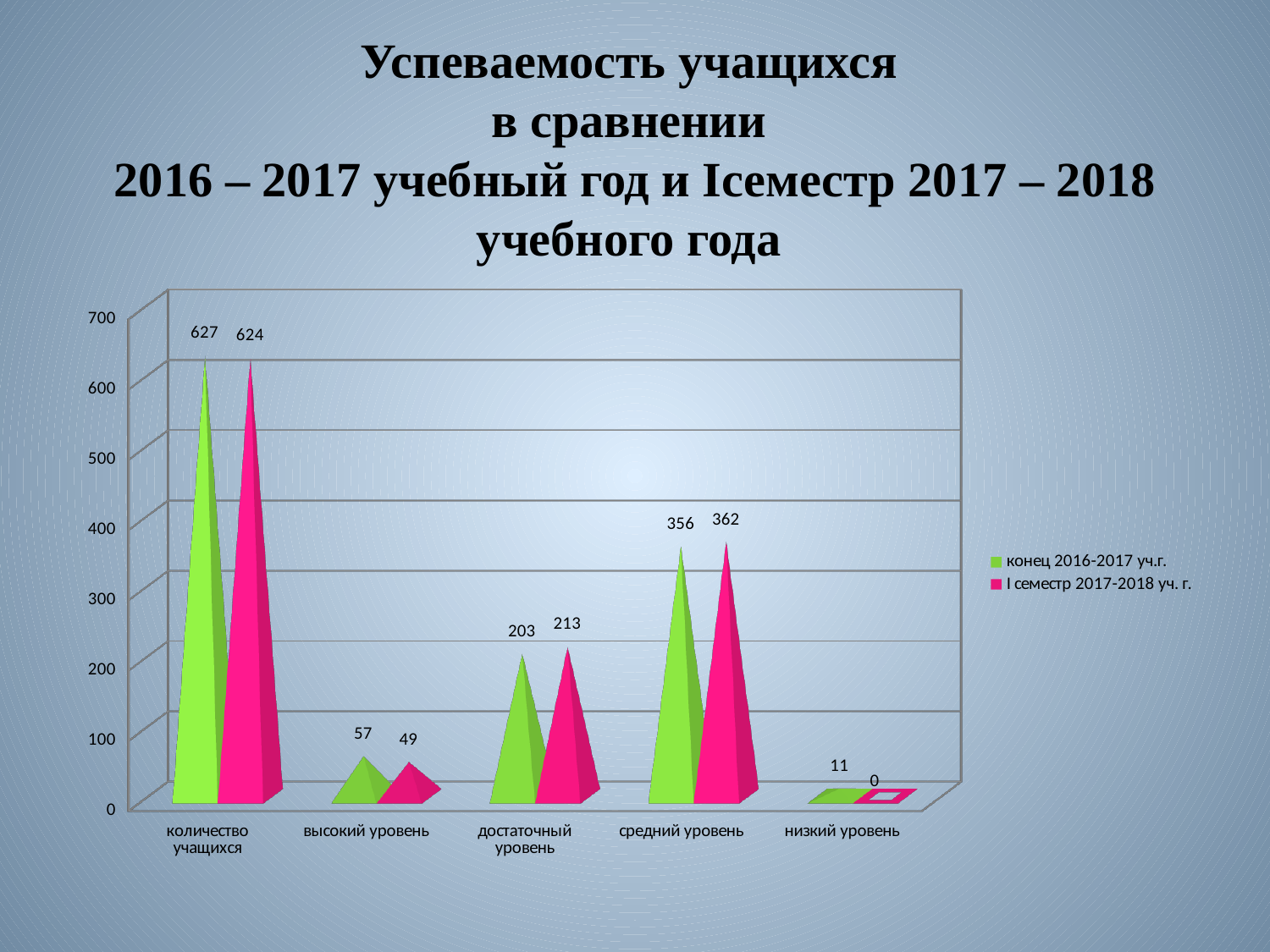
What is the value for "высокий уровень" in the "конец 2016-2017 уч.г." series? 57 What kind of chart is shown on the slide? bar chart How many series does the legend list? 2 What is the value for "низкий уровень" in the "I семестр 2017-2018 уч. г." series? 0 What is the value for "количество учащихся" in the "конец 2016-2017 уч.г." series? 627 What is the value for "средний уровень" in the "I семестр 2017-2018 уч. г." series? 362 Which category has the highest value in the "I семестр 2017-2018 уч. г." series? количество учащихся What is the difference between the two series' values for "достаточный уровень"? 10 For "высокий уровень", which series has the larger value? конец 2016-2017 уч.г. What colour represents the "I семестр 2017-2018 уч. г." series? pink How many categories are shown on the x axis? 5 Which category has the lowest value in the "конец 2016-2017 уч.г." series? низкий уровень